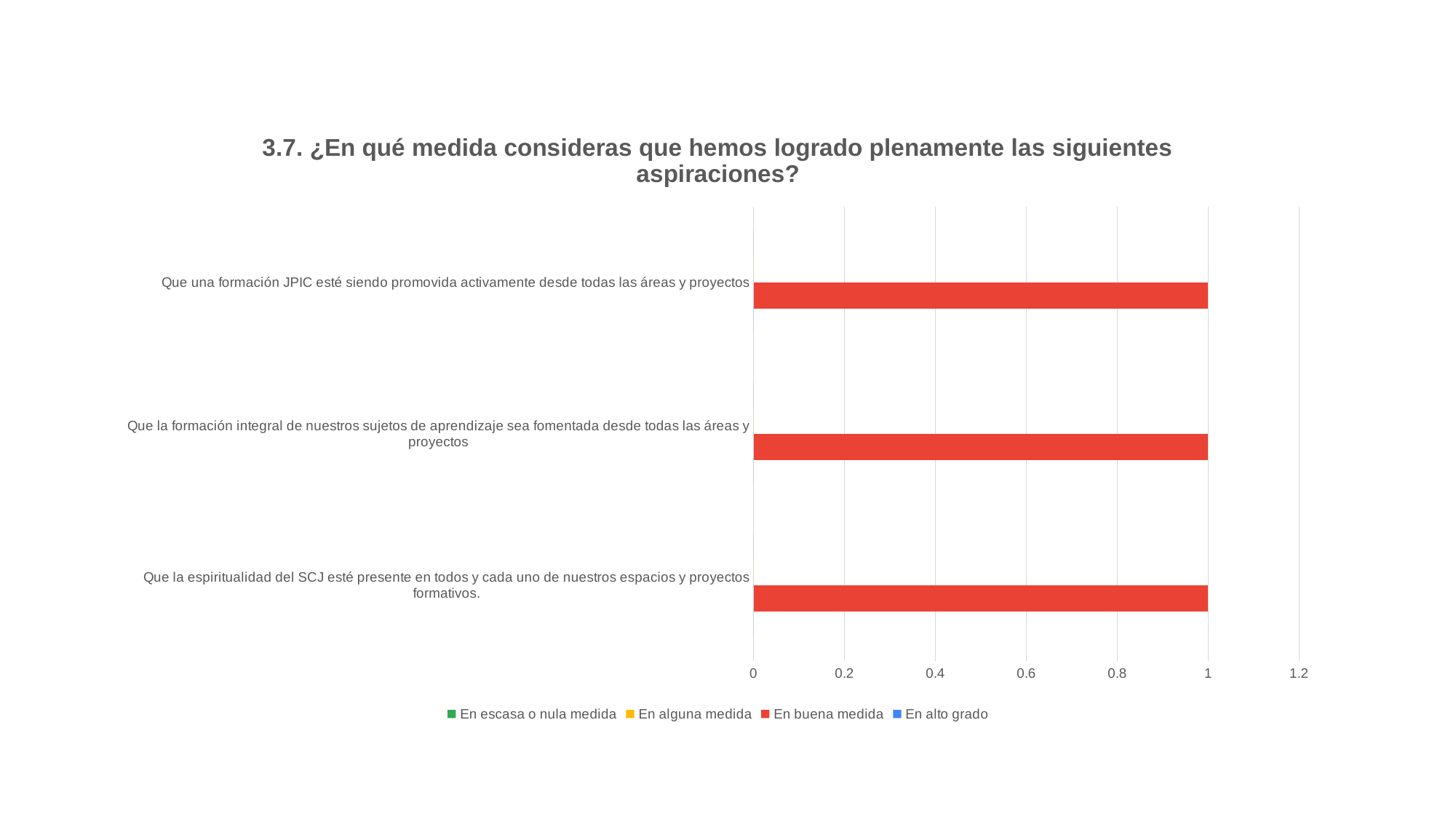
What is the difference between the 'En buena medida' values for the JPIC formation aspiration and the SCJ spirituality aspiration? 0 How many series does the chart's legend list? 4 How many categories (aspirations) are listed on the vertical axis of the chart? 3 Is the 'En buena medida' value for 'Que la espiritualidad del SCJ esté presente en todos y cada uno de nuestros espacios y proyectos formativos.' greater or less than 1.2? less What is the value of the 'En buena medida' bar for 'Que una formación JPIC esté siendo promovida activamente desde todas las áreas y proyectos'? 1 What is the value of the 'En buena medida' bar for 'Que la espiritualidad del SCJ esté presente en todos y cada uno de nuestros espacios y proyectos formativos.'? 1 What kind of chart is shown on the slide? bar chart Is the 'En buena medida' value for 'Que una formación JPIC esté siendo promovida activamente desde todas las áreas y proyectos' greater or less than 0.8? greater Which series in the legend is shown in red? En buena medida What is the highest value shown on the horizontal axis of the chart? 1.2 What is the value of the 'En buena medida' bar for 'Que la formación integral de nuestros sujetos de aprendizaje sea fomentada desde todas las áreas y proyectos'? 1